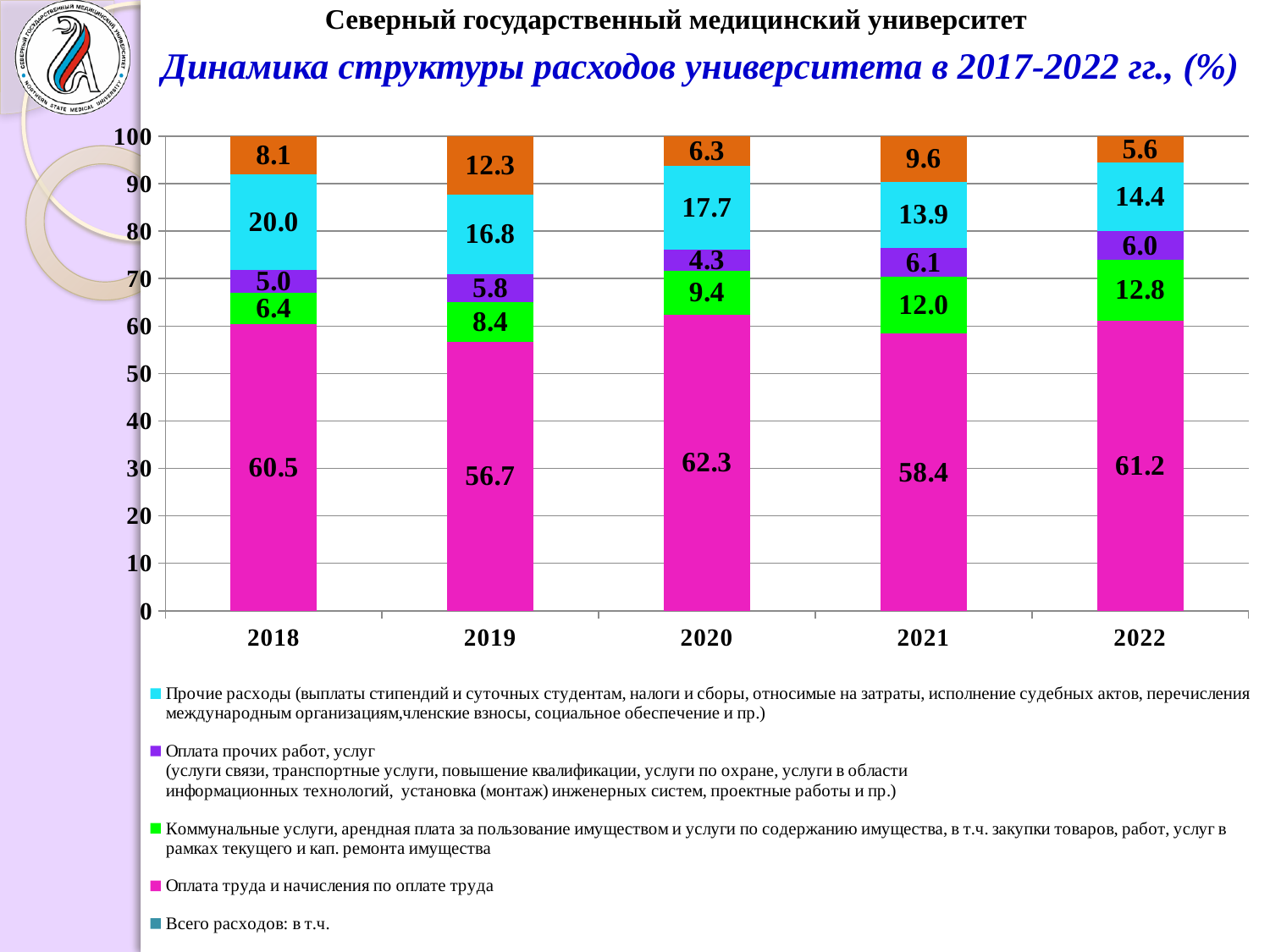
Какой тип диаграммы показан на слайде? Столбчатая диаграмма с накоплением Что больше: доля коммунальных услуг в 2019 году или в 2021 году? 2021 год В каком году доля расходов на оплату труда была наименьшей? 2019 На сколько процентных пунктов доля прочих расходов (голубой сегмент) в 2018 году больше, чем в 2022 году? 5.6 Какова доля расходов на оплату труда и начисления по оплате труда в 2020 году? 62.3 Какова доля коммунальных услуг, арендной платы и услуг по содержанию имущества в 2022 году? 12.8 Сколько лет (категорий) показано на диаграмме? 5 Сколько позиций перечислено в легенде диаграммы? 5 Какова доля оплаты прочих работ, услуг (фиолетовый сегмент) в 2021 году? 6.1 В каком году доля расходов на оплату труда была наибольшей? 2020 Какова доля прочих расходов (голубой сегмент) в 2018 году? 20.0 Как изменяется доля коммунальных услуг, арендной платы и услуг по содержанию имущества с 2018 по 2022 год? Растёт